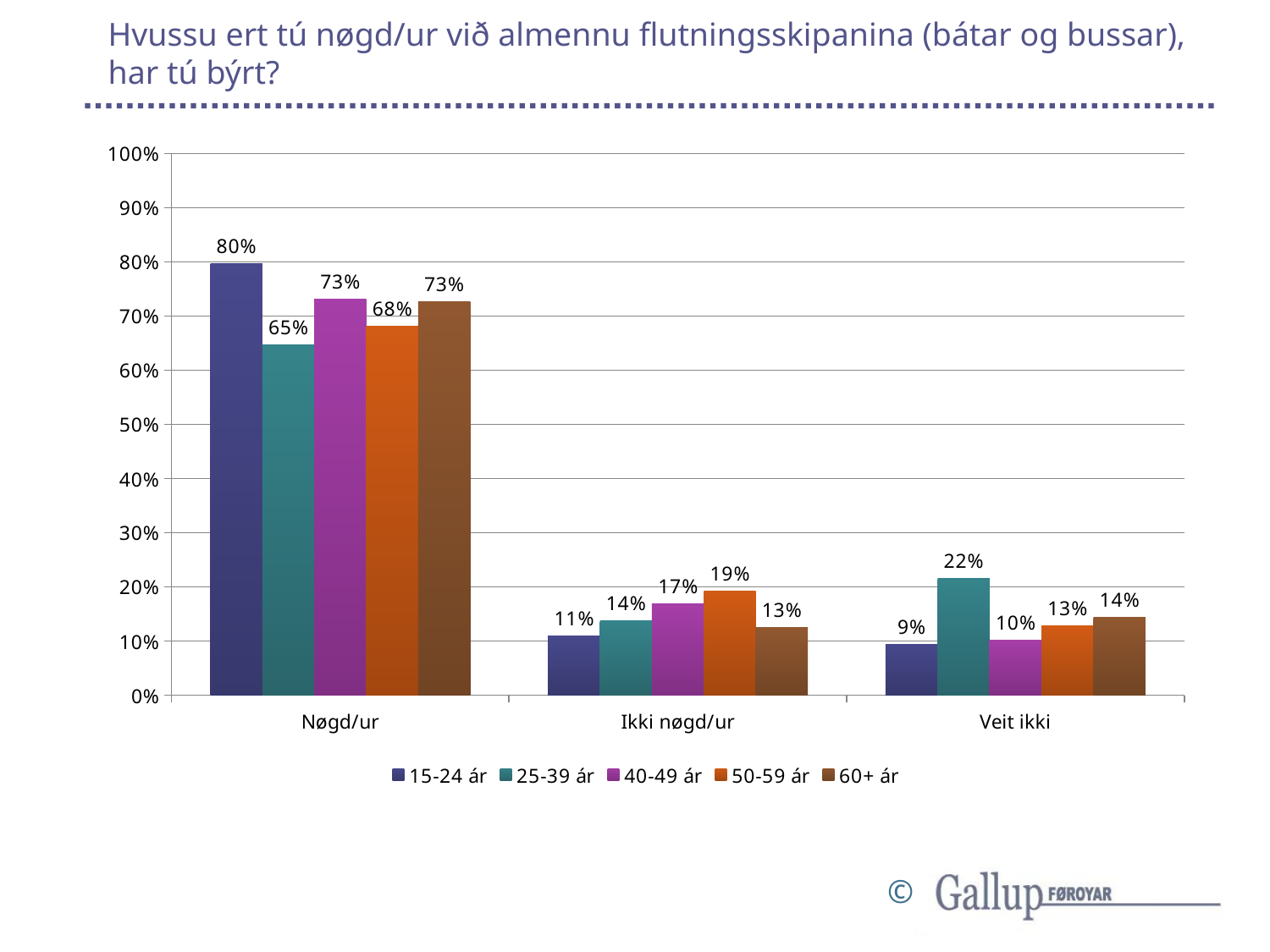
Which age group has the highest value in the Nøgd/ur category? 15-24 ár What is the value for the 15-24 ár series in the Nøgd/ur category? 80% Which age group has the lowest value in the Veit ikki category? 15-24 ár What is the value for the 25-39 ár series in the Veit ikki category? 22% What is the difference between the 15-24 ár and 25-39 ár values in the Nøgd/ur category? 15% Which series is shown in orange in the legend? 50-59 ár What is the value for the 50-59 ár series in the Ikki nøgd/ur category? 19% How many categories are shown on the x axis? 3 Is the value for 50-59 ár in the Nøgd/ur category greater or less than 60%? greater What kind of chart is shown on the slide? Bar chart How many series does the legend list? 5 Which is larger in the Ikki nøgd/ur category: the 40-49 ár value or the 60+ ár value? 40-49 ár